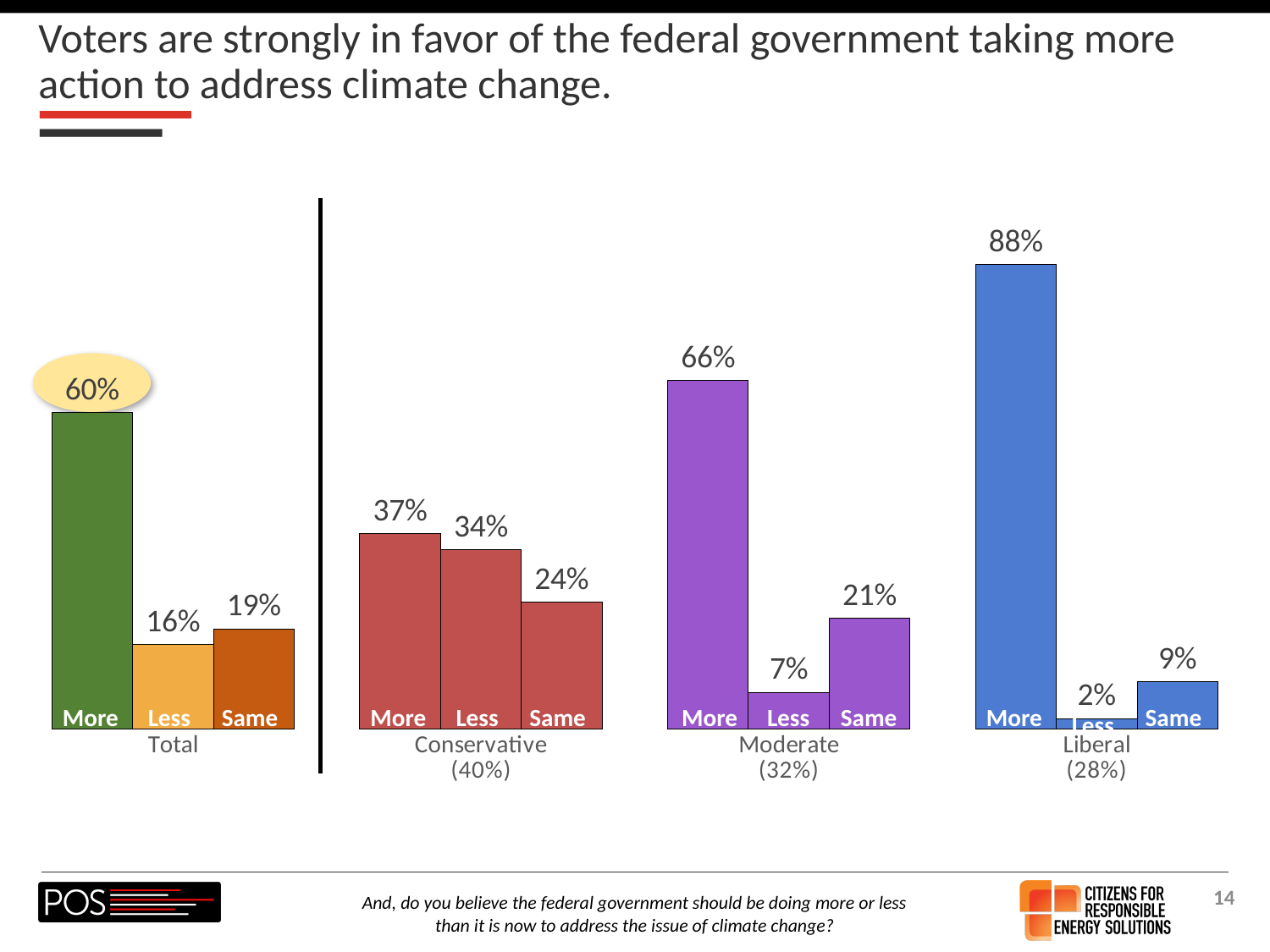
What is the value for "Less" among Conservative voters? 34% What is the value for "More" among Liberal voters? 88% Which group has the highest value for "More"? Liberal What percentage of Total voters say the federal government should be doing "More" to address climate change? 60% What share of the sample is labeled as Conservative? 40% What is the difference between the "More" values for Liberal and Conservative voters? 51 percentage points How many response categories are shown for each voter group? 3 Which response has the lowest value among Liberal voters? Less What is the value for "Same" among Moderate voters? 21% Among Total voters, which is larger: the value for "Less" or the value for "Same"? Same What type of chart is used on this slide? Bar chart What is the difference between the "More" and "Less" values among Moderate voters? 59 percentage points